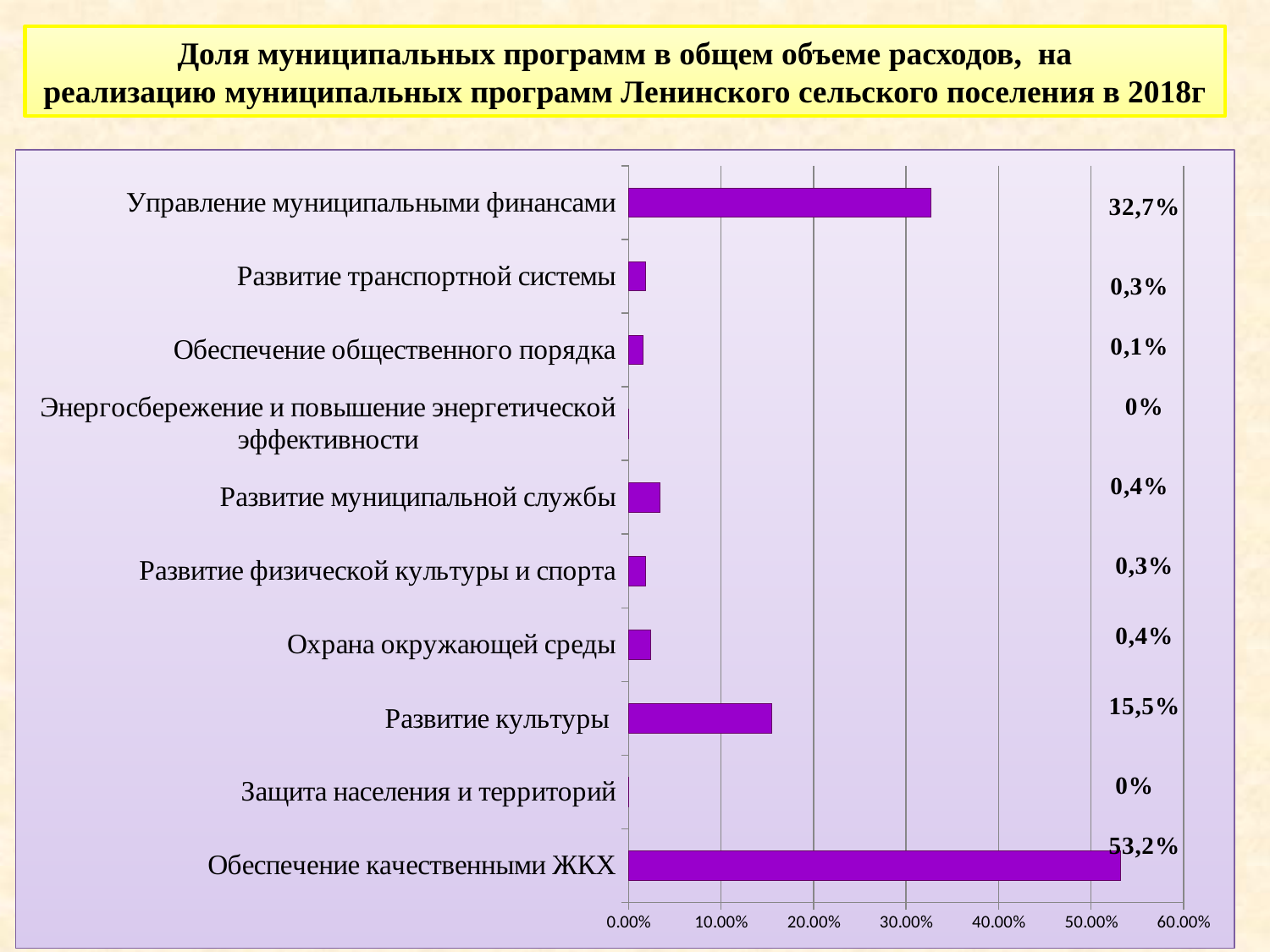
What is the difference between the values for Обеспечение качественными ЖКХ and Управление муниципальными финансами? 20,5% Is the value for Развитие культуры greater or less than 20.00%? less What kind of chart is shown on the slide? Bar chart What is the value for Развитие муниципальной службы? 0,4% What is the highest value shown on the horizontal axis? 60.00% What is the value for Обеспечение качественными ЖКХ? 53,2% What is the value for Развитие культуры? 15,5% What is the value for Управление муниципальными финансами? 32,7% Which category has the highest value? Обеспечение качественными ЖКХ Which is larger, the value for Развитие культуры or the value for Управление муниципальными финансами? Управление муниципальными финансами Is the value for Обеспечение качественными ЖКХ greater or less than 50.00%? greater How many categories are shown in the chart? 10